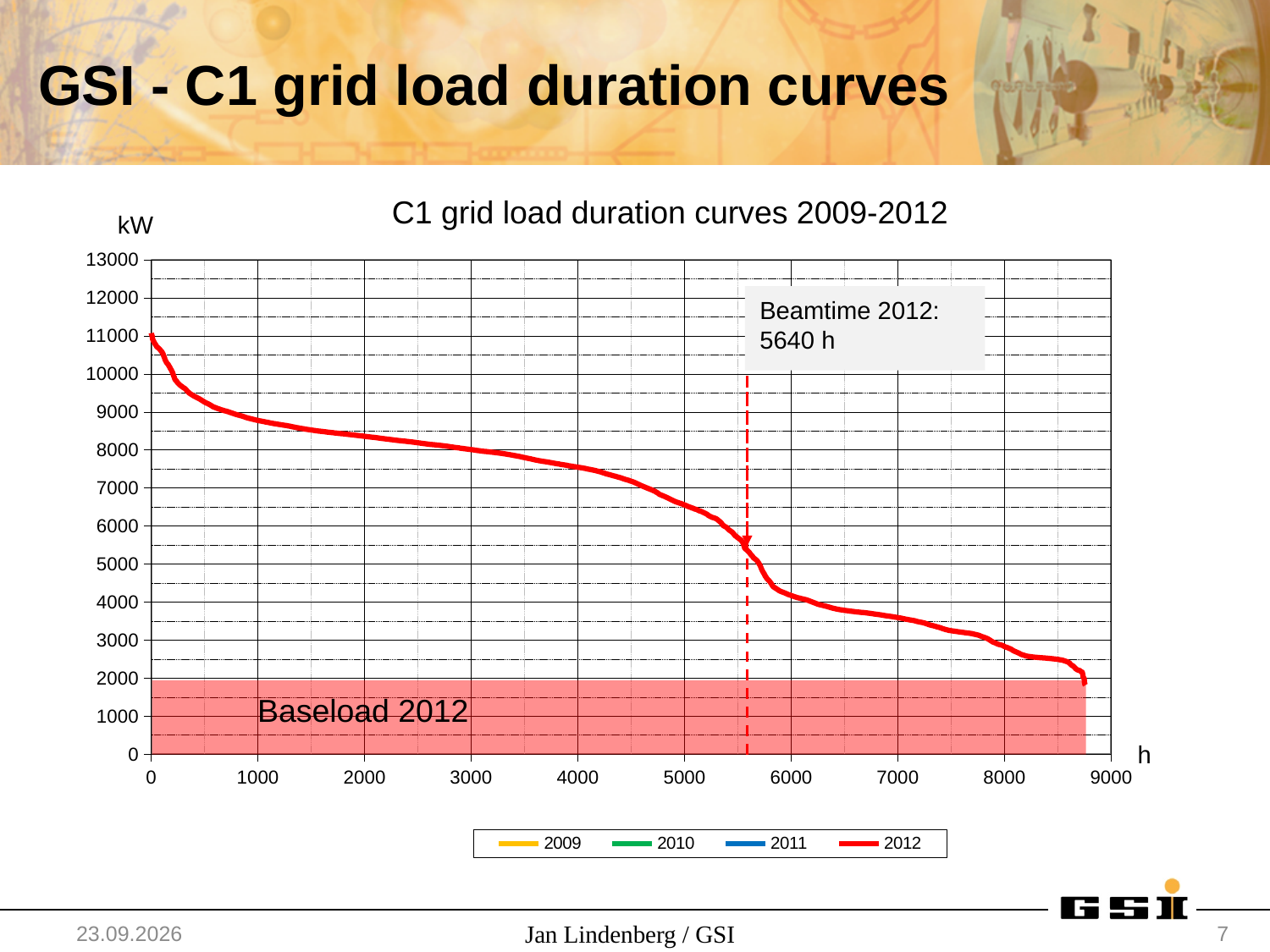
What kind of chart is shown on the slide? line chart How many series does the legend list? 4 Is the 2012 value at 5000 h greater or less than 7000 kW? less Is the 2012 value at 1000 h greater or less than 8000 kW? greater Is the 2012 value at 4000 h greater or less than 7000 kW? greater Does the 2012 curve rise or fall as the hours on the x axis increase? fall What is the title of the chart? C1 grid load duration curves 2009-2012 According to the annotation on the chart, how many hours was the beamtime in 2012? 5640 h